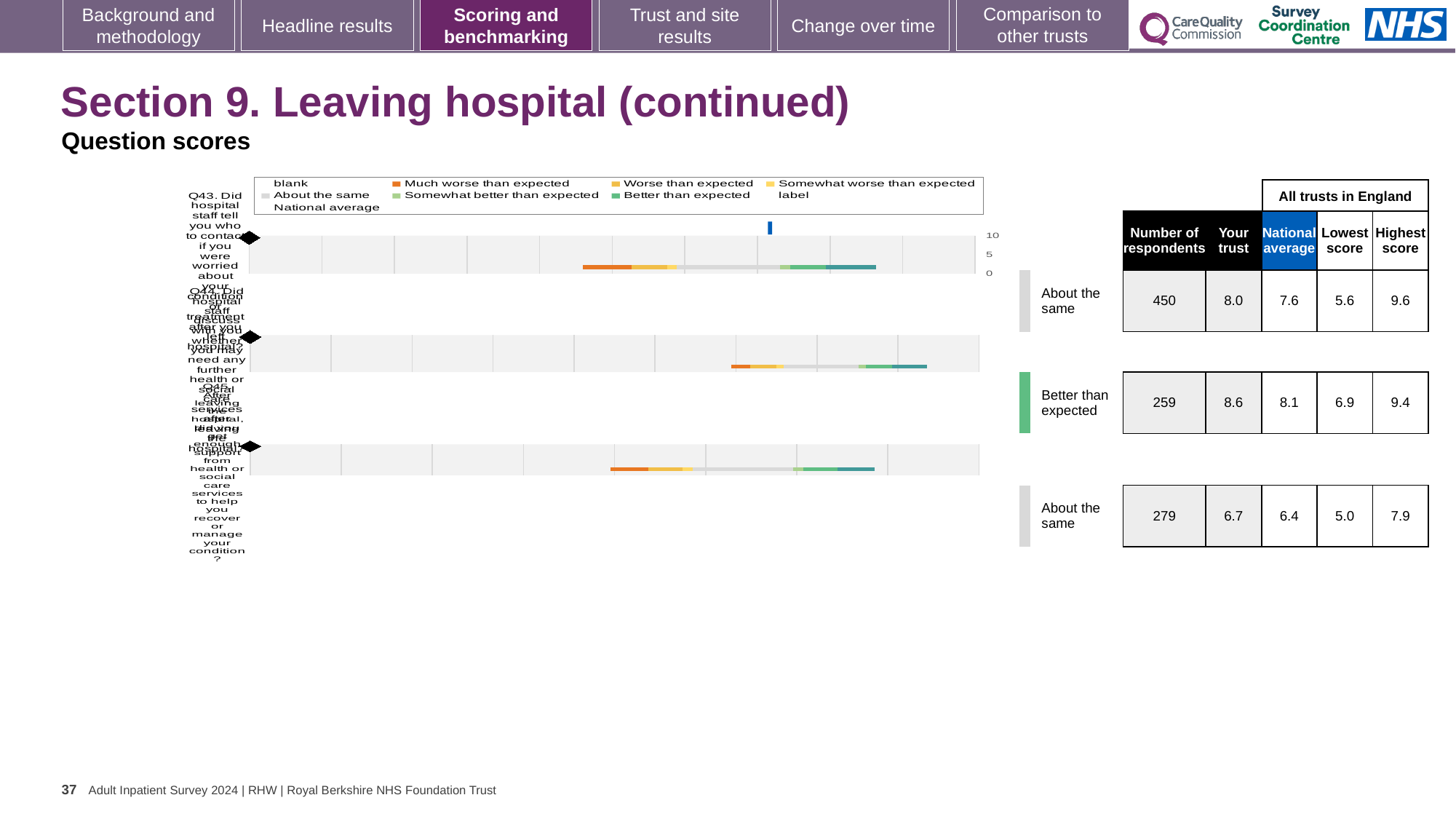
How many question rows are plotted in the chart? 3 Which benchmark category is shown for the second question row? Better than expected What is the lowest score across all trusts in England for the third question row (279 respondents)? 5.0 What is the 'Your trust' score for the first question row (About the same, 450 respondents)? 8.0 What is the highest score across all trusts in England for the first question row (450 respondents)? 9.6 What is the difference between the 'Your trust' score and the national average for the second question row (Better than expected)? 0.5 Which question row has the highest 'Your trust' score? the second row (Better than expected, 8.6) What type of chart is shown on the slide? bar chart How many respondents answered the third question row (About the same, Your trust 6.7)? 279 What is the national average for the second question row (Better than expected)? 8.1 Is the 'Your trust' score for the first question row (450 respondents) larger than its national average? Yes, 8.0 vs 7.6 Which question row has the lowest number of respondents? the second row (Better than expected, 259)